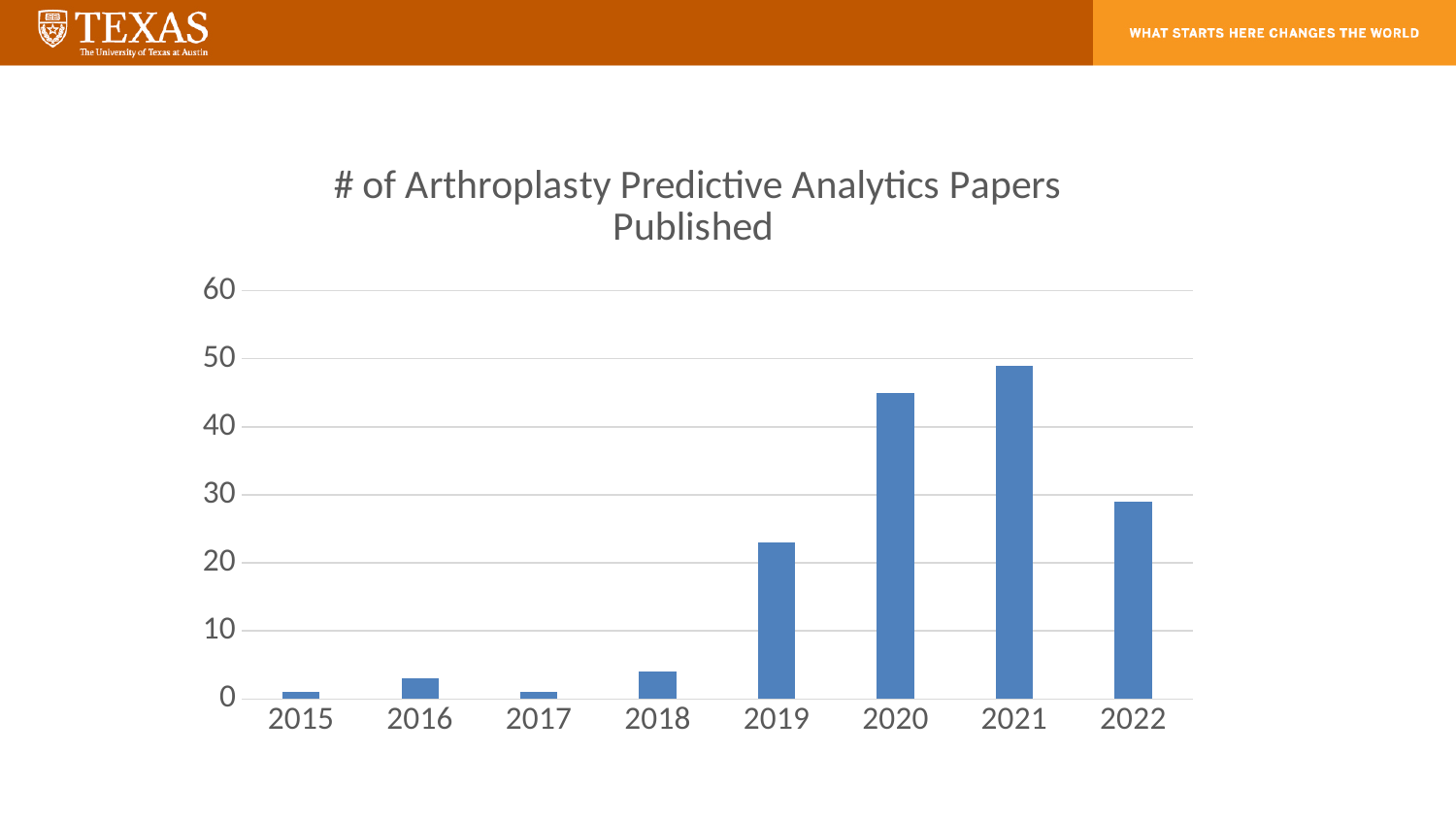
What is the title of the chart? # of Arthroplasty Predictive Analytics Papers Published Which year has the larger value, 2019 or 2020? 2020 How do the values change from 2018 to 2021? They rise Is the value for 2019 greater or less than 20? greater What kind of chart is shown on the slide? Bar chart Which year has the larger value, 2022 or 2019? 2022 How many years are shown on the x axis of the chart? 8 Which year has the highest number of papers published? 2021 Is the value for 2018 greater or less than 10? less Is the value for 2020 greater or less than 40? greater